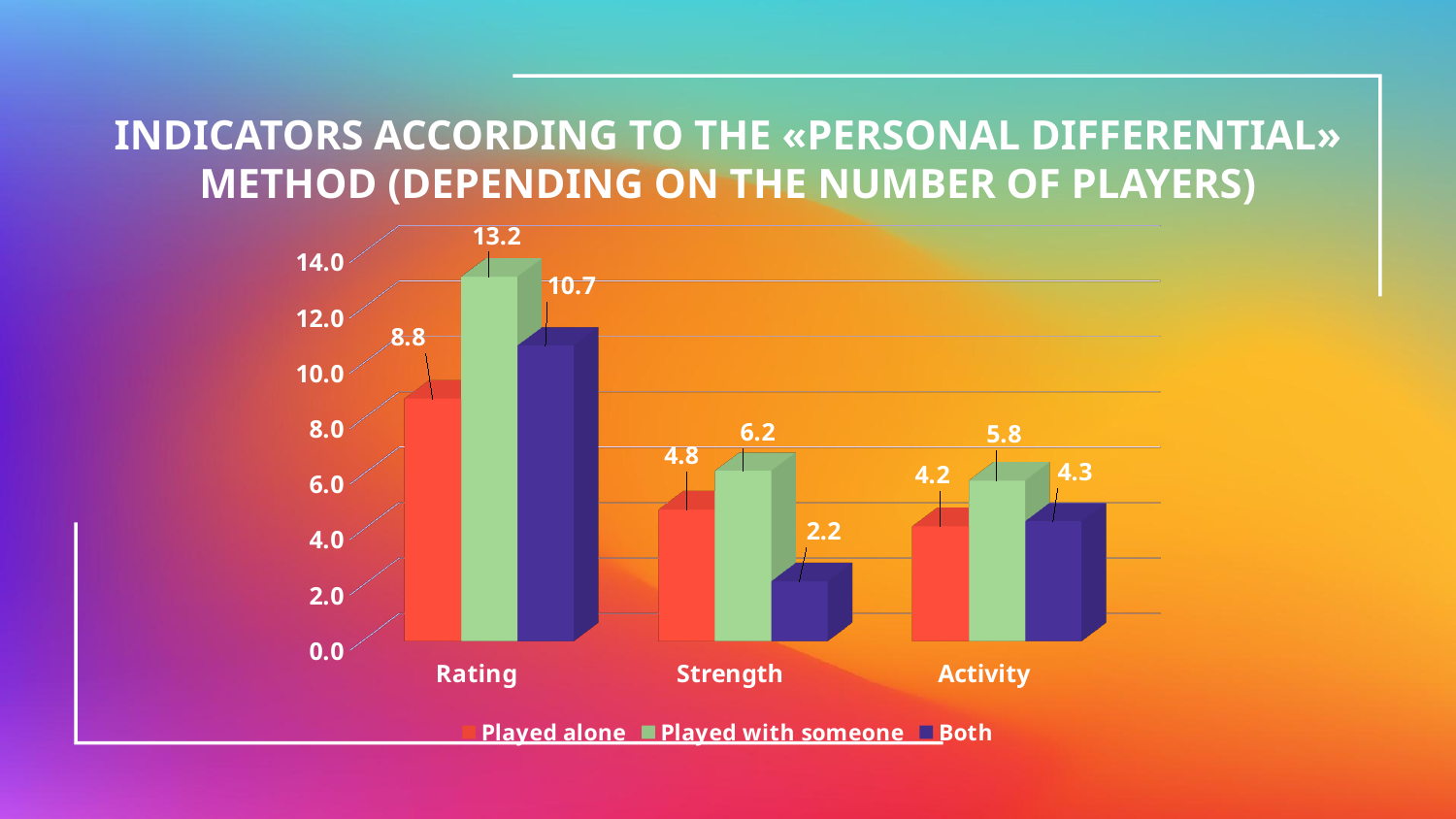
What kind of chart is shown on the slide? Bar chart What is the value for "Played alone" in the Activity category? 4.2 What colour are the bars for the "Played with someone" series? Green Which series has the lowest value in the Strength category? Both How many series does the legend list? 3 What is the value for "Both" in the Strength category? 2.2 Which series has the highest value in the Rating category? Played with someone Which is larger in the Activity category: "Played alone" or "Both"? Both What is the value for "Played with someone" in the Rating category? 13.2 Is the value for "Both" in the Rating category greater or less than 10.0? greater What is the difference between "Played with someone" and "Played alone" in the Rating category? 4.4 How many categories are shown on the x axis? 3